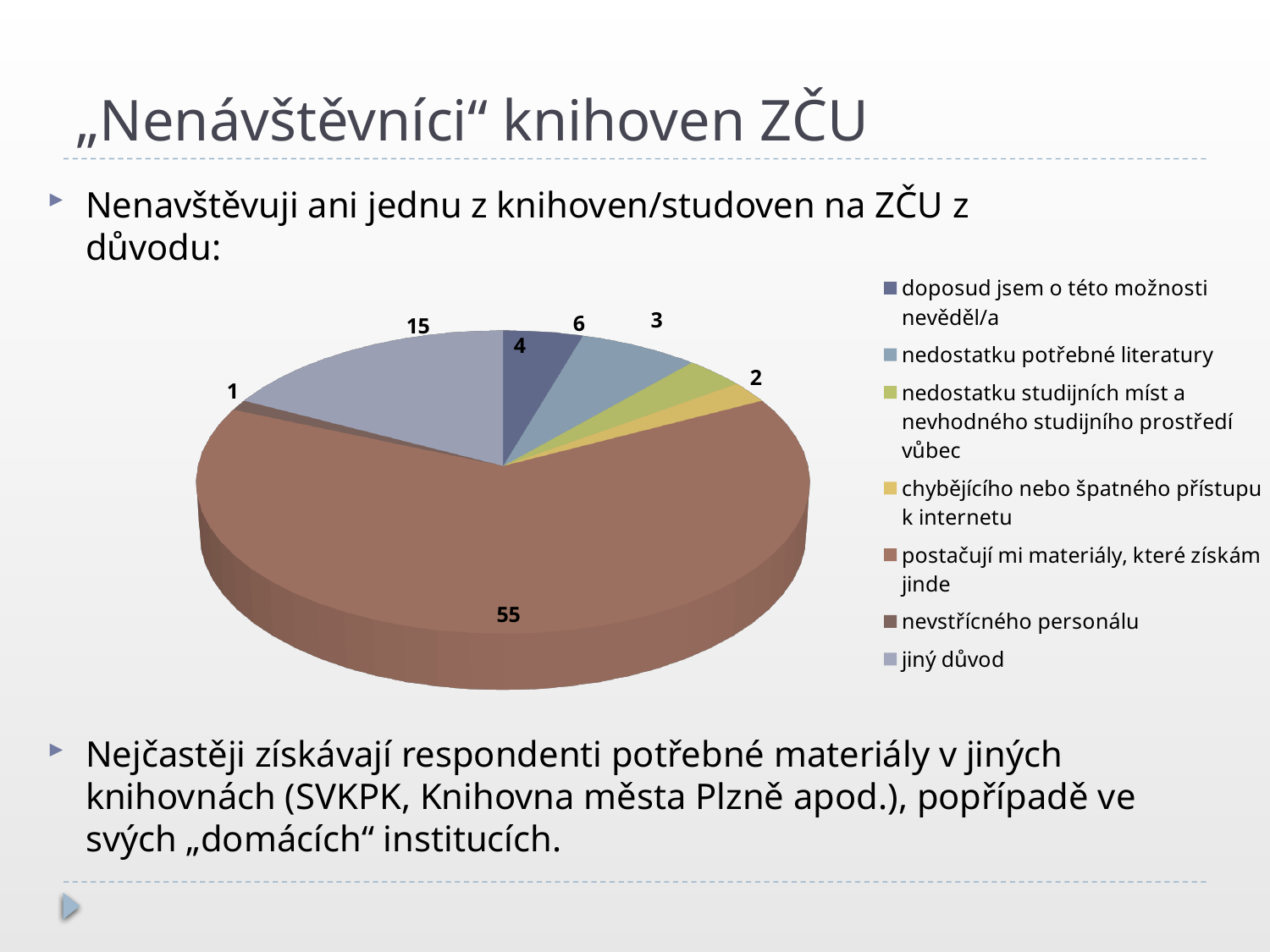
Which is larger: the value for "nedostatku potřebné literatury" or the value for "chybějícího nebo špatného přístupu k internetu"? nedostatku potřebné literatury What is the value for "nevstřícného personálu"? 1 Which category has the smallest slice of the pie? nevstřícného personálu How many slices does the pie chart have? 7 Which category has the largest slice of the pie? postačují mi materiály, které získám jinde What kind of chart is shown on the slide? pie chart What is the value for "doposud jsem o této možnosti nevěděl/a"? 4 What is the value for "postačují mi materiály, které získám jinde"? 55 What is the value for "nedostatku potřebné literatury"? 6 How many entries does the legend of the pie chart list? 7 What is the value for "jiný důvod"? 15 What is the difference between the values for "postačují mi materiály, které získám jinde" and "jiný důvod"? 40